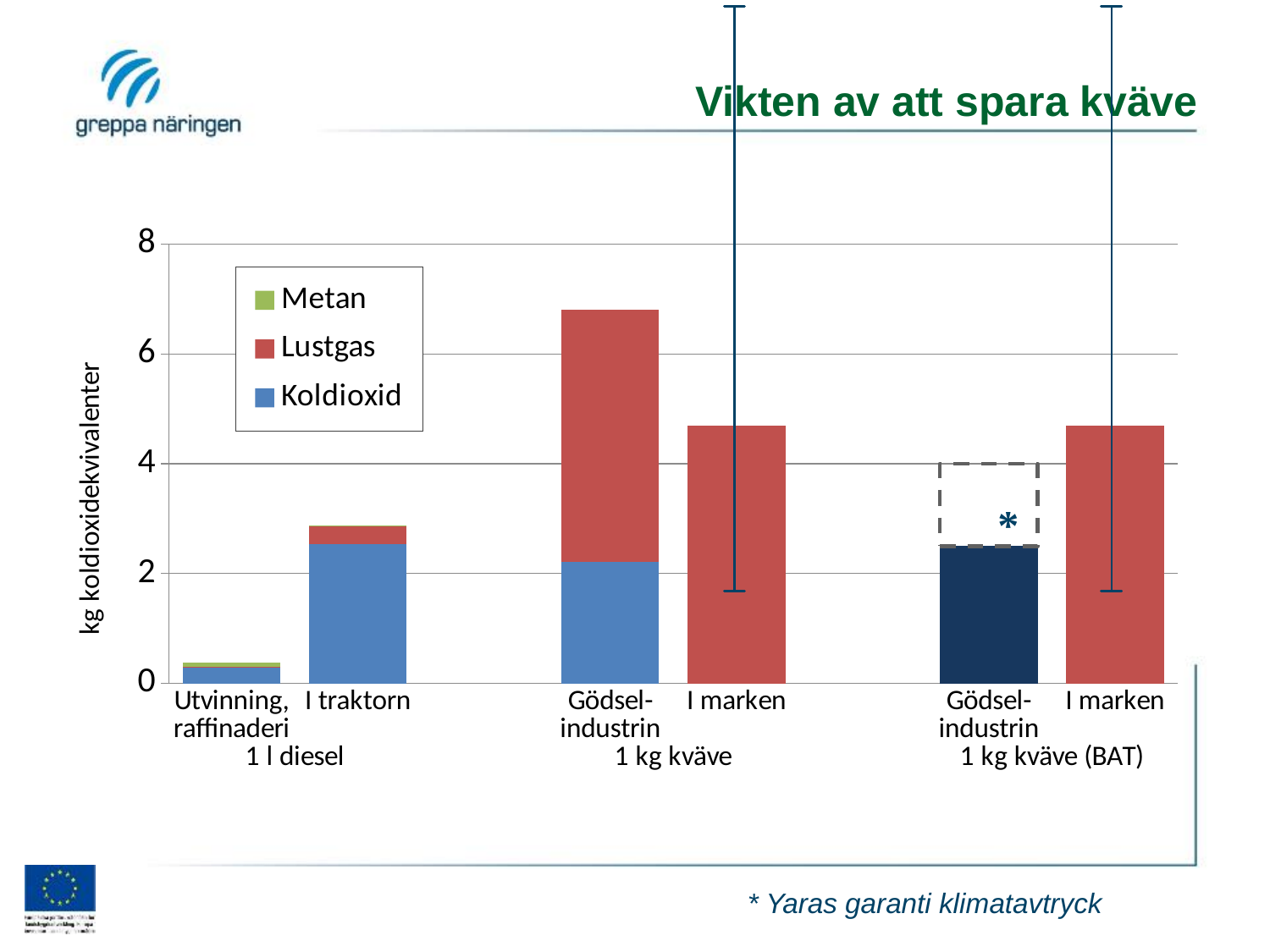
What is the title of the chart? Vikten av att spara kväve What kind of chart is shown on the slide? bar chart Which bar has the highest total value? Gödsel-industrin (1 kg kväve) Which bar has the lowest total value? Utvinning, raffinaderi Is the total value for Gödsel-industrin (1 kg kväve) greater or less than 6? greater Is the total value for I traktorn greater or less than 2? greater Which is larger, the total for I traktorn or the total for Gödsel-industrin (1 kg kväve)? Gödsel-industrin (1 kg kväve) Is the value for I marken (1 kg kväve) greater or less than 4? greater How many bars are plotted in the chart? 6 How many series does the legend list? 3 What is the label of the vertical axis? kg koldioxidekvivalenter